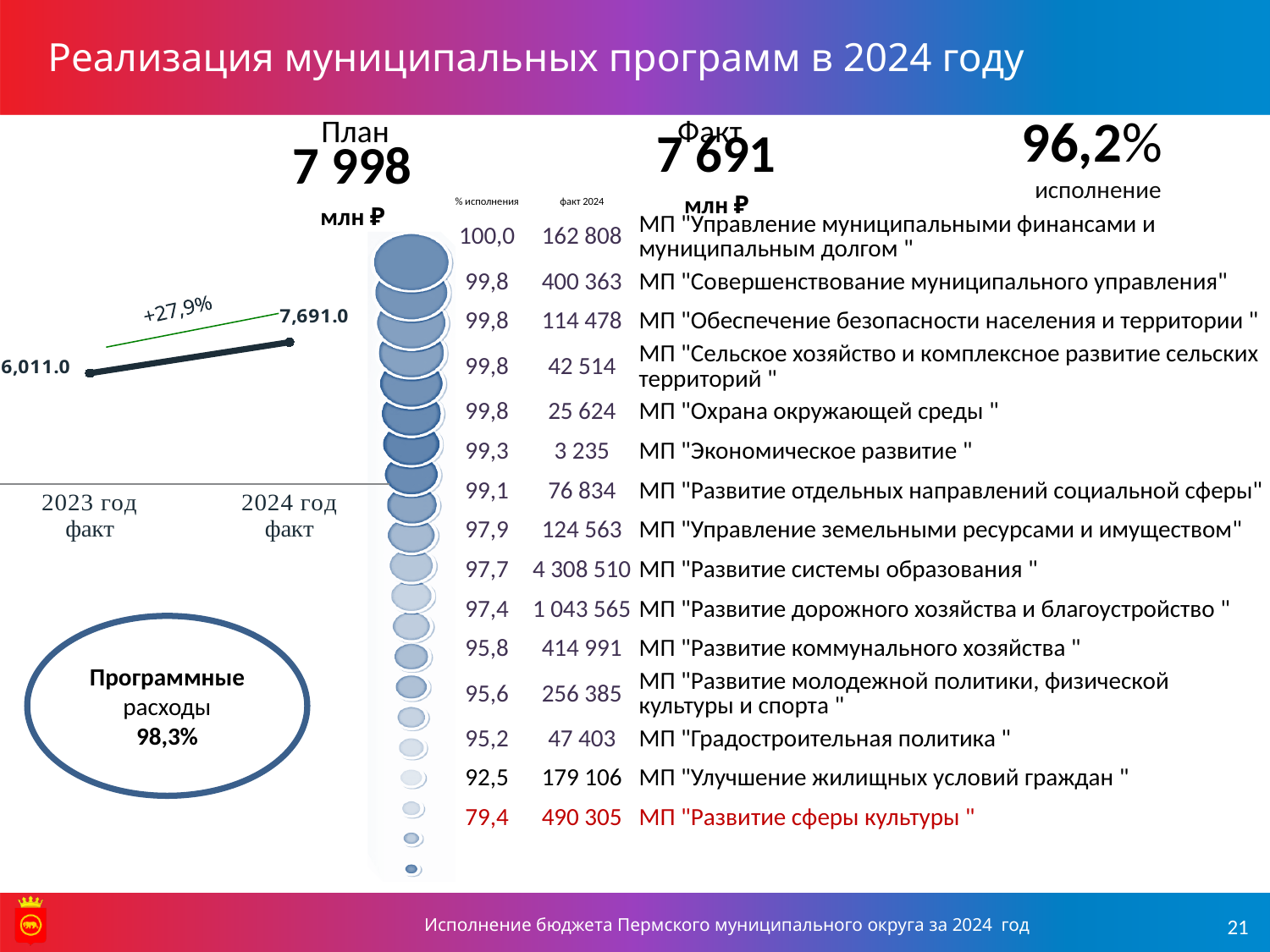
On the line chart at the left, what is the difference between the 2024 and 2023 values? 1,680.0 On the line chart at the left, what is the value for 2024 год факт? 7,691.0 On the line chart at the left, is the value for 2024 год факт larger or smaller than the value for 2023 год факт? larger In the list of municipal programs with circles, which program has the lowest % исполнения? МП "Развитие сферы культуры" On the line chart at the left, what percentage change is printed above the line? +27,9% On the line chart at the left, which year has the higher value? 2024 год факт On the line chart at the left, how many data points are plotted? 2 In the list of municipal programs with circles, what is the факт 2024 value for МП "Развитие системы образования"? 4 308 510 On the line chart at the left, do the values rise or fall from 2023 to 2024? rise On the line chart at the left, what is the value for 2023 год факт? 6,011.0 What kind of chart is shown at the left of the slide, below the 'План' figure? line chart On the line chart at the left, which year has the lower value? 2023 год факт